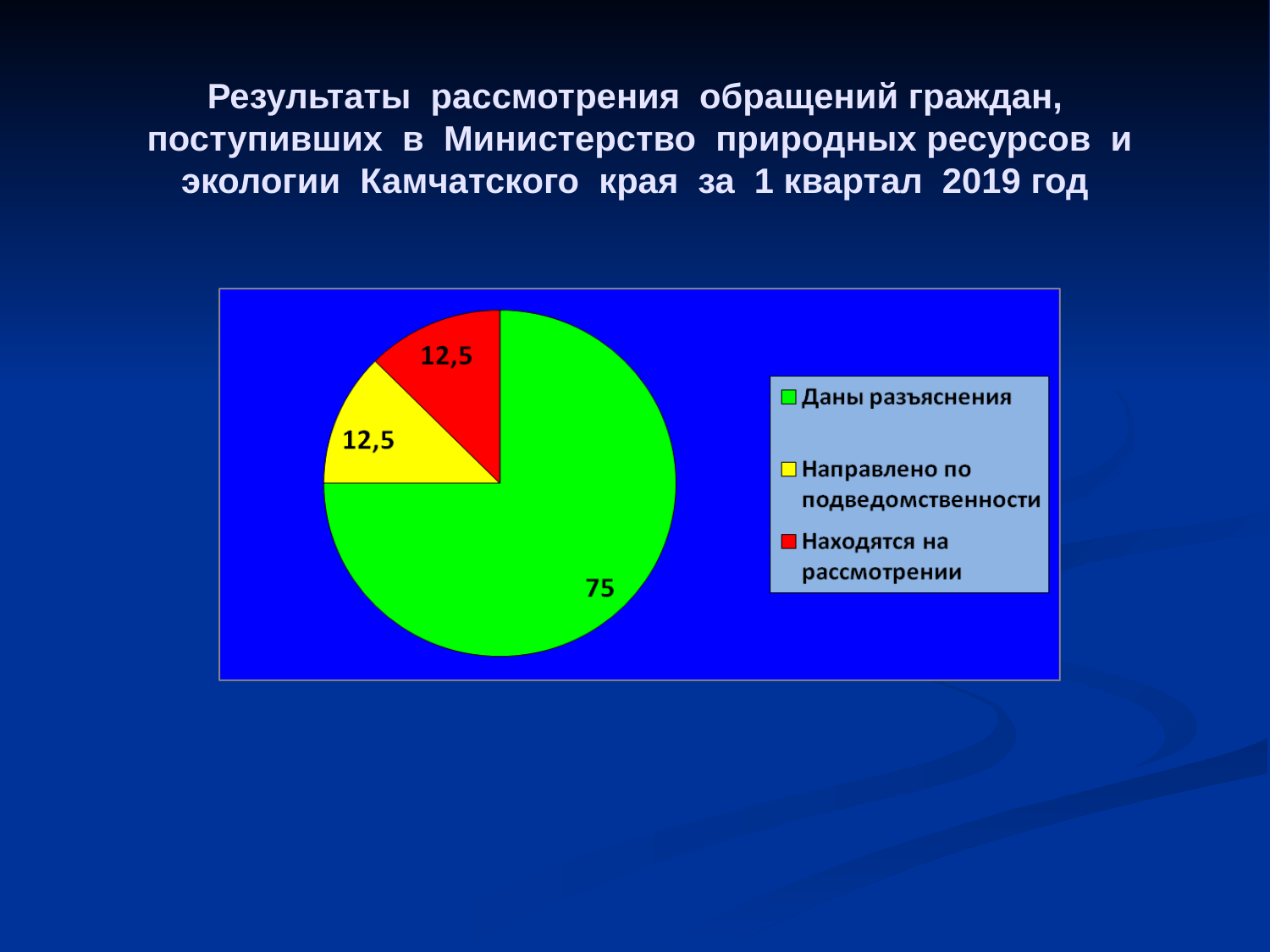
Which category has the largest slice of the pie? Даны разъяснения What colour is the slice for "Находятся на рассмотрении"? red What is the value for "Направлено по подведомственности"? 12,5 What is the difference between the values for "Даны разъяснения" and "Находятся на рассмотрении"? 62,5 Which is larger, the value for "Даны разъяснения" or the value for "Направлено по подведомственности"? Даны разъяснения What colour is the slice for "Даны разъяснения"? green What kind of chart is shown on the slide? pie chart What is the total of all three slice values? 100 What is the value for "Даны разъяснения"? 75 How many entries does the legend list? 3 What is the value for "Находятся на рассмотрении"? 12,5 How many slices does the pie chart have? 3